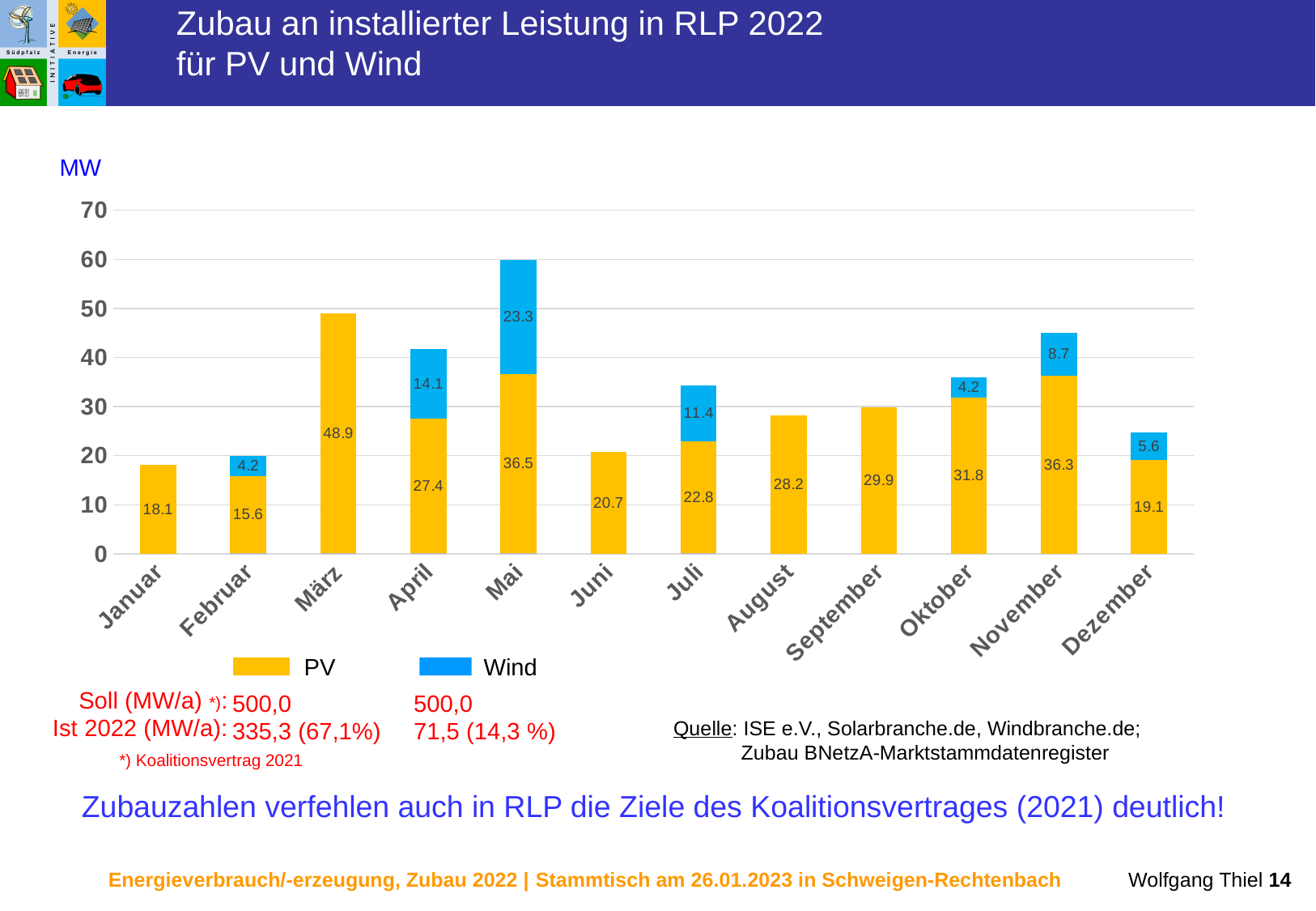
What is the PV value for März? 48.9 What kind of chart is shown on the slide? Stacked bar chart How many series does the legend list? 2 Which month has the lowest PV value? Februar Which month has the highest Wind value? Mai How many months are shown on the x axis? 12 What is the PV value for Dezember? 19.1 Which month has the highest PV value? März What is the difference between the PV values for Mai and Juni? 15.8 Which is larger, the Wind value for April or the Wind value for Juli? April What is the Wind value for Mai? 23.3 What is the total of the stacked bar for Mai? 59.8